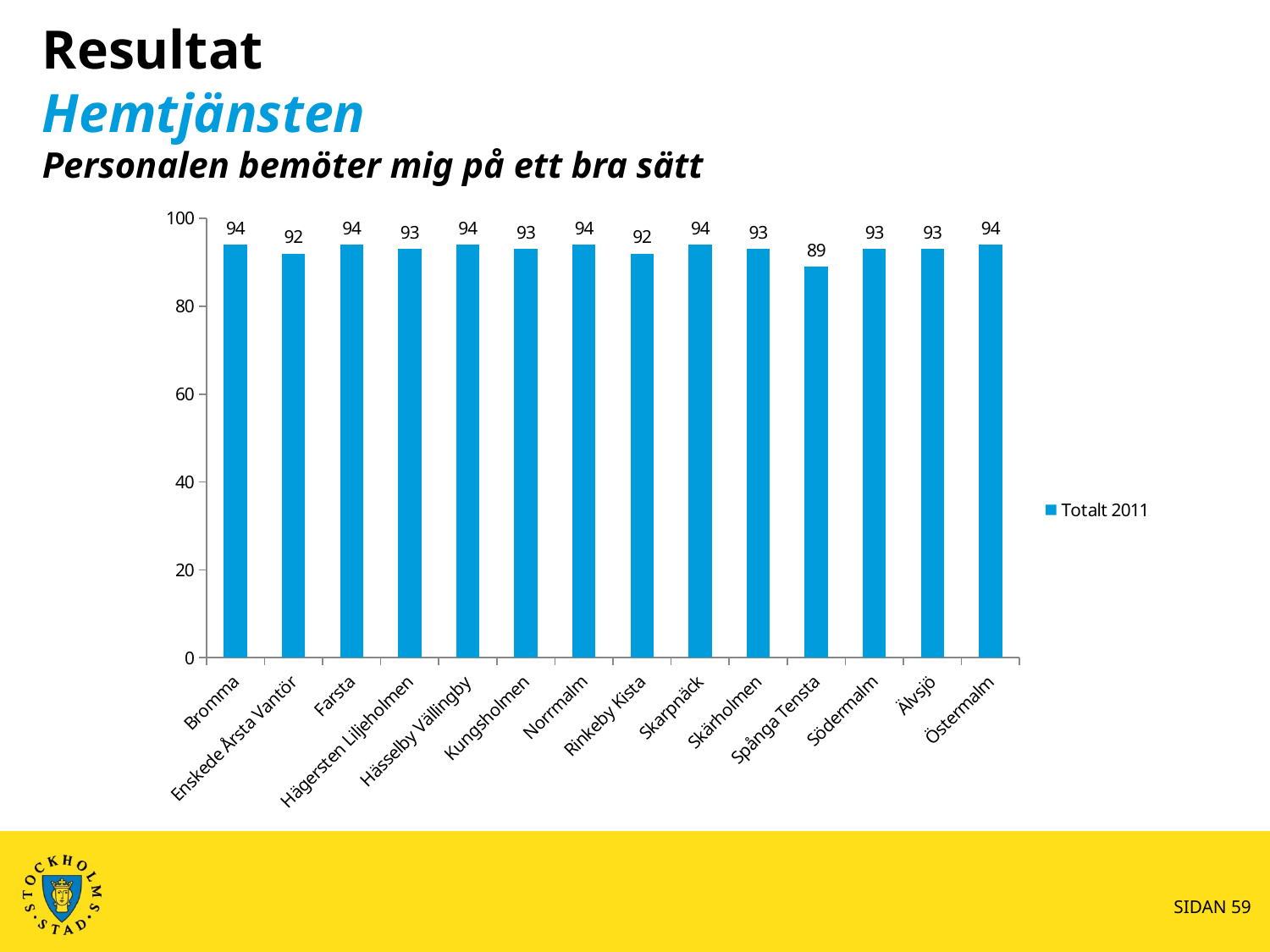
How many series does the legend list? 1 Is the value for Kungsholmen greater or less than 80? greater What is the value for Bromma? 94 What is the difference between the values for Farsta and Enskede Årsta Vantör? 2 What is the value for Rinkeby Kista? 92 Which category has the lowest value? Spånga Tensta What kind of chart is shown on the slide? Bar chart What is the difference between the values for Bromma and Spånga Tensta? 5 How many categories are shown on the x axis? 14 Which has a higher value, Norrmalm or Spånga Tensta? Norrmalm What is the value for Spånga Tensta? 89 What is the value for Södermalm? 93